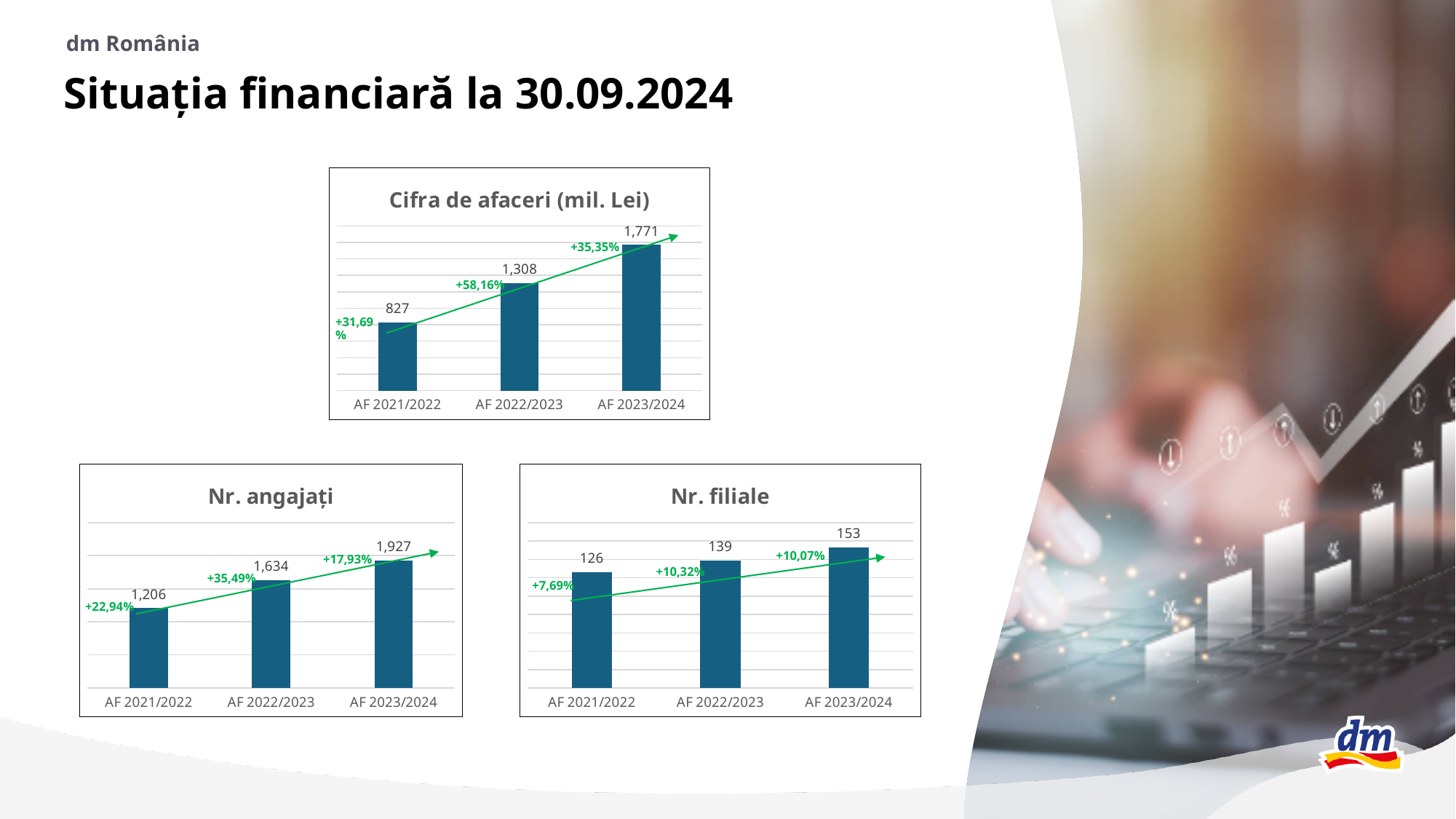
In the 'Cifra de afaceri (mil. Lei)' chart, what is the difference between AF 2022/2023 and AF 2021/2022? 481 In the 'Nr. angajați' chart, what is the difference between AF 2023/2024 and AF 2022/2023? 293 In the 'Cifra de afaceri (mil. Lei)' chart, what is the value for AF 2021/2022? 827 In the 'Nr. filiale' chart, do the values rise or fall from AF 2021/2022 to AF 2023/2024? rise What kind of chart is the 'Nr. angajați' chart? bar chart In the 'Nr. angajați' chart, what is the value for AF 2022/2023? 1,634 In the 'Nr. filiale' chart, what is the value for AF 2021/2022? 126 In the 'Nr. angajați' chart, which period has the highest value? AF 2023/2024 How many periods are shown on the x axis of the 'Cifra de afaceri (mil. Lei)' chart? 3 In the 'Nr. filiale' chart, which period has the lowest value? AF 2021/2022 In the 'Cifra de afaceri (mil. Lei)' chart, what is the value for AF 2023/2024? 1,771 In the 'Nr. filiale' chart, what is the difference between AF 2023/2024 and AF 2021/2022? 27